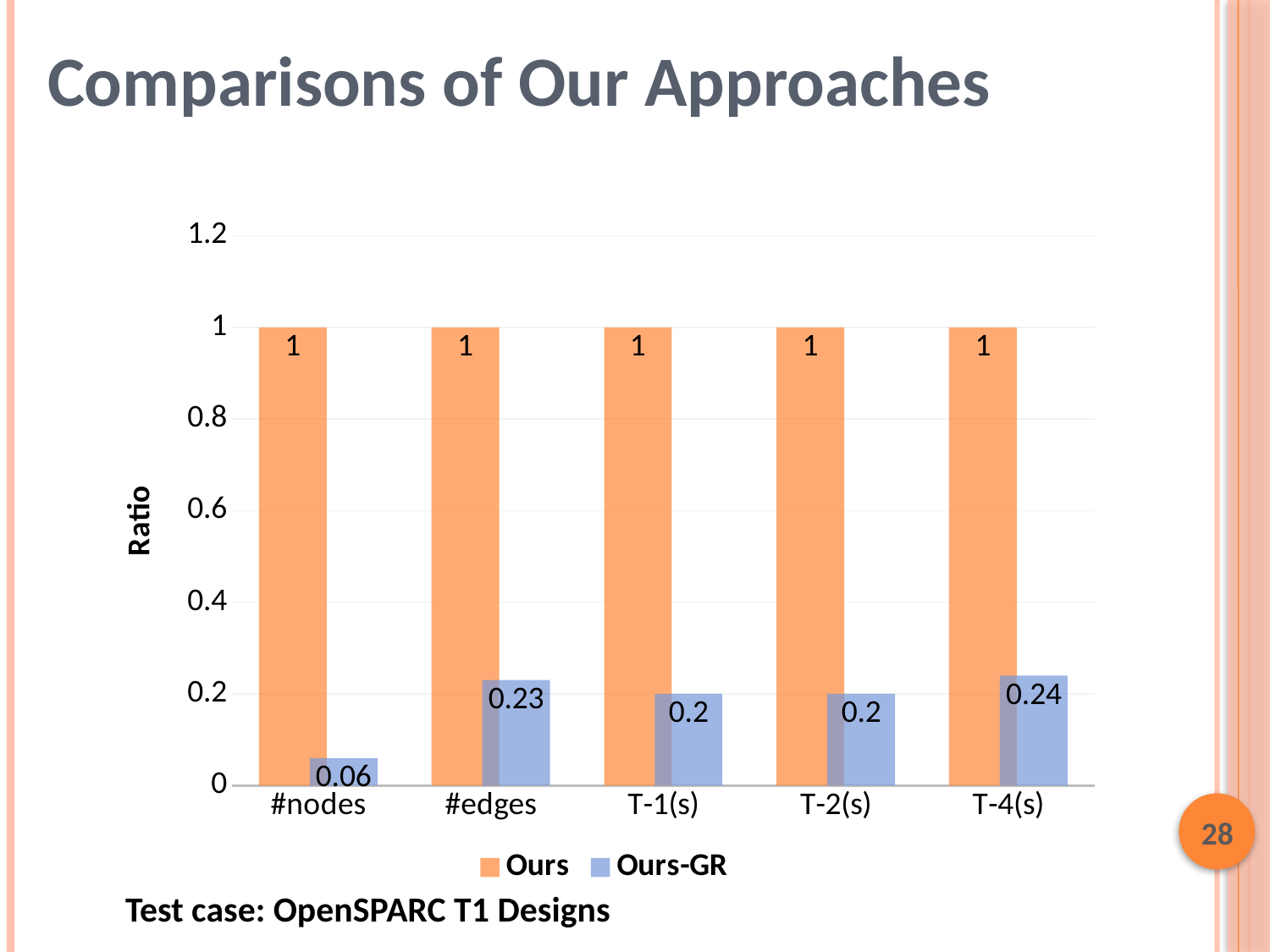
What is the label of the y axis? Ratio What is the Ours-GR value for #nodes? 0.06 What is the Ours value for T-2(s)? 1 Which category has the highest Ours-GR value? T-4(s) What is the difference between the Ours and Ours-GR values for #edges? 0.77 What is the Ours-GR value for T-4(s)? 0.24 What is the Ours-GR value for #edges? 0.23 How many categories are shown on the x axis? 5 What kind of chart is shown on the slide? Bar chart Which is larger for T-1(s): the Ours value or the Ours-GR value? Ours Which category has the lowest Ours-GR value? #nodes How many series does the legend list? 2